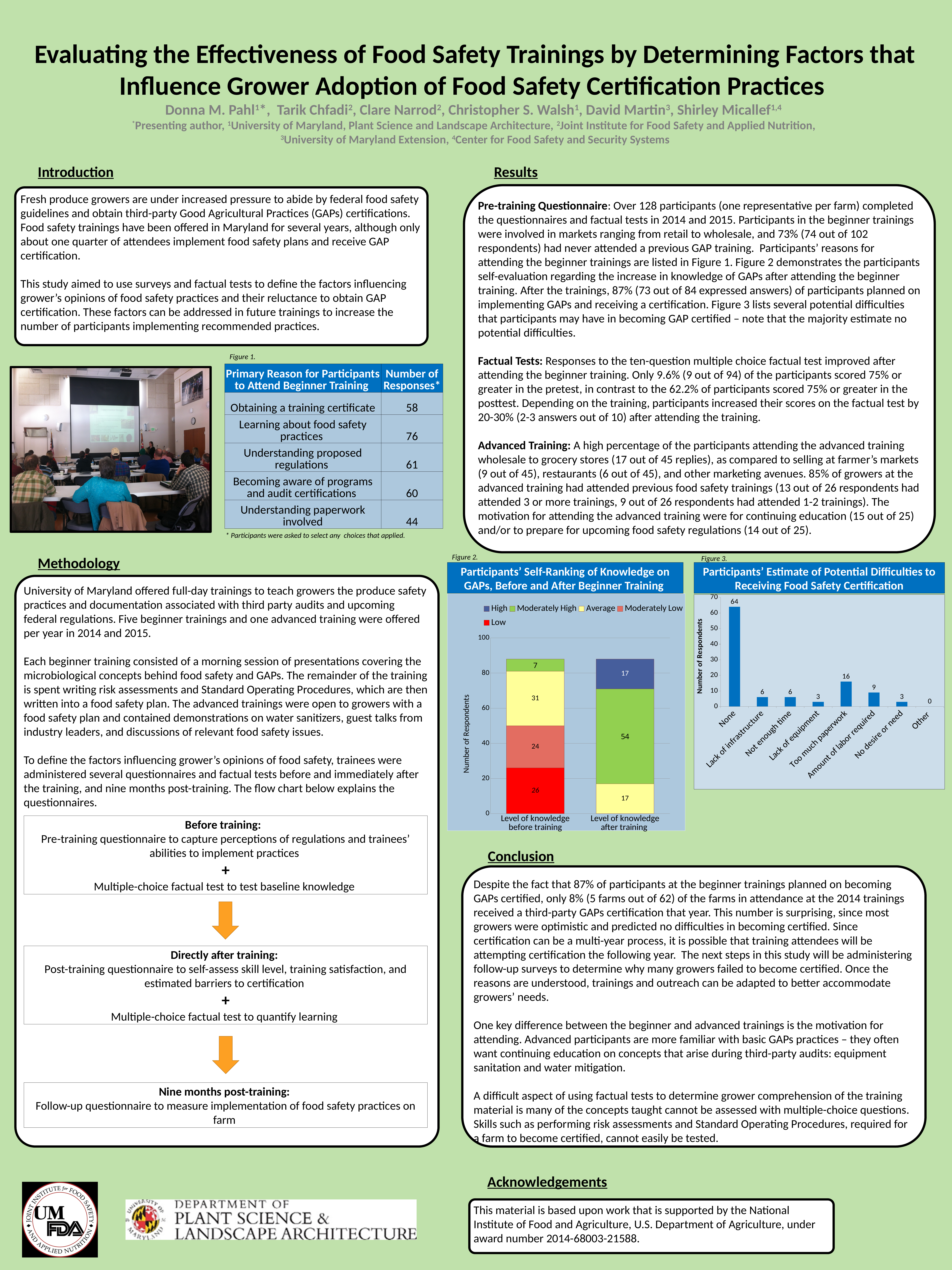
In the chart titled "Participants' Estimate of Potential Difficulties to Receiving Food Safety Certification", how many respondents selected "None"? 64 In the chart titled "Participants' Self-Ranking of Knowledge on GAPs, Before and After Beginner Training", how many respondents rated their knowledge as "Low" before training? 26 In the chart titled "Participants' Self-Ranking of Knowledge on GAPs, Before and After Beginner Training", what is the total of the "Level of knowledge before training" stacked bar? 88 What kind of chart is the one titled "Participants' Estimate of Potential Difficulties to Receiving Food Safety Certification"? Bar chart In the chart titled "Participants' Self-Ranking of Knowledge on GAPs, Before and After Beginner Training", how many series does the legend list? 5 In the chart titled "Participants' Self-Ranking of Knowledge on GAPs, Before and After Beginner Training", how many respondents rated their knowledge as "Moderately High" after training? 54 In the chart titled "Participants' Estimate of Potential Difficulties to Receiving Food Safety Certification", which category has the lowest number of respondents? Other In the chart titled "Participants' Estimate of Potential Difficulties to Receiving Food Safety Certification", how many respondents selected "Too much paperwork"? 16 In the chart titled "Participants' Self-Ranking of Knowledge on GAPs, Before and After Beginner Training", which is larger: the "Average" segment before training or the "Average" segment after training? Before training In the chart titled "Participants' Estimate of Potential Difficulties to Receiving Food Safety Certification", what is the difference between the number of respondents for "Too much paperwork" and "Amount of labor required"? 7 In the chart titled "Participants' Estimate of Potential Difficulties to Receiving Food Safety Certification", how many categories are shown on the x axis? 8 In the chart titled "Participants' Estimate of Potential Difficulties to Receiving Food Safety Certification", which category has the highest number of respondents? None